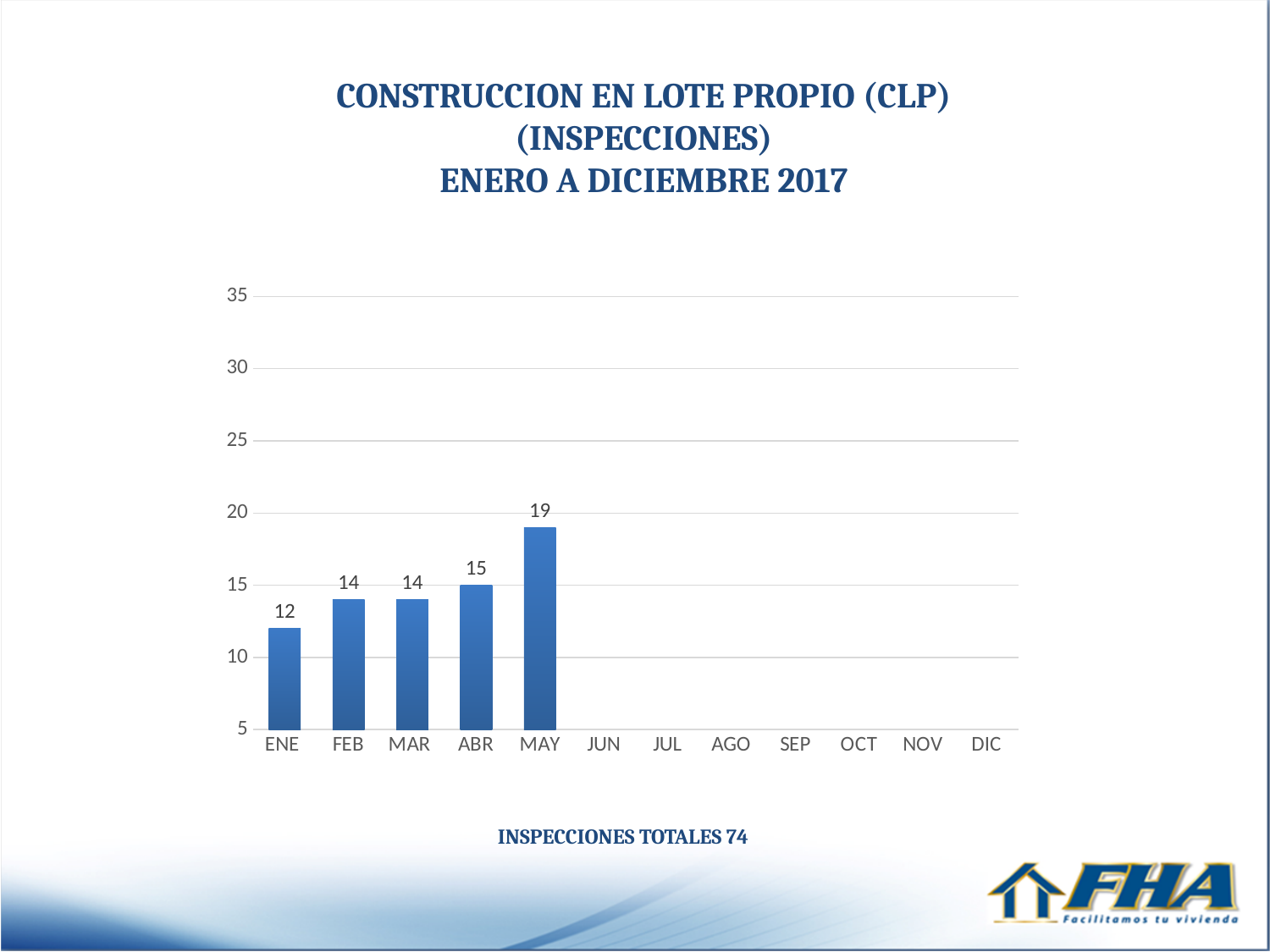
Which is larger, the value for ABR or the value for FEB? ABR What kind of chart is shown? bar chart What is the value for ENE? 12 What is the value for ABR? 15 What total number of inspections is stated below the chart? 74 Which month has the highest value? MAY Among the months with bars, which has the lowest value? ENE How many months are labelled on the x axis? 12 How many months have a bar plotted? 5 What is the value for MAY? 19 Is the value for MAY greater or less than 15? greater What is the difference between the values for MAY and ENE? 7